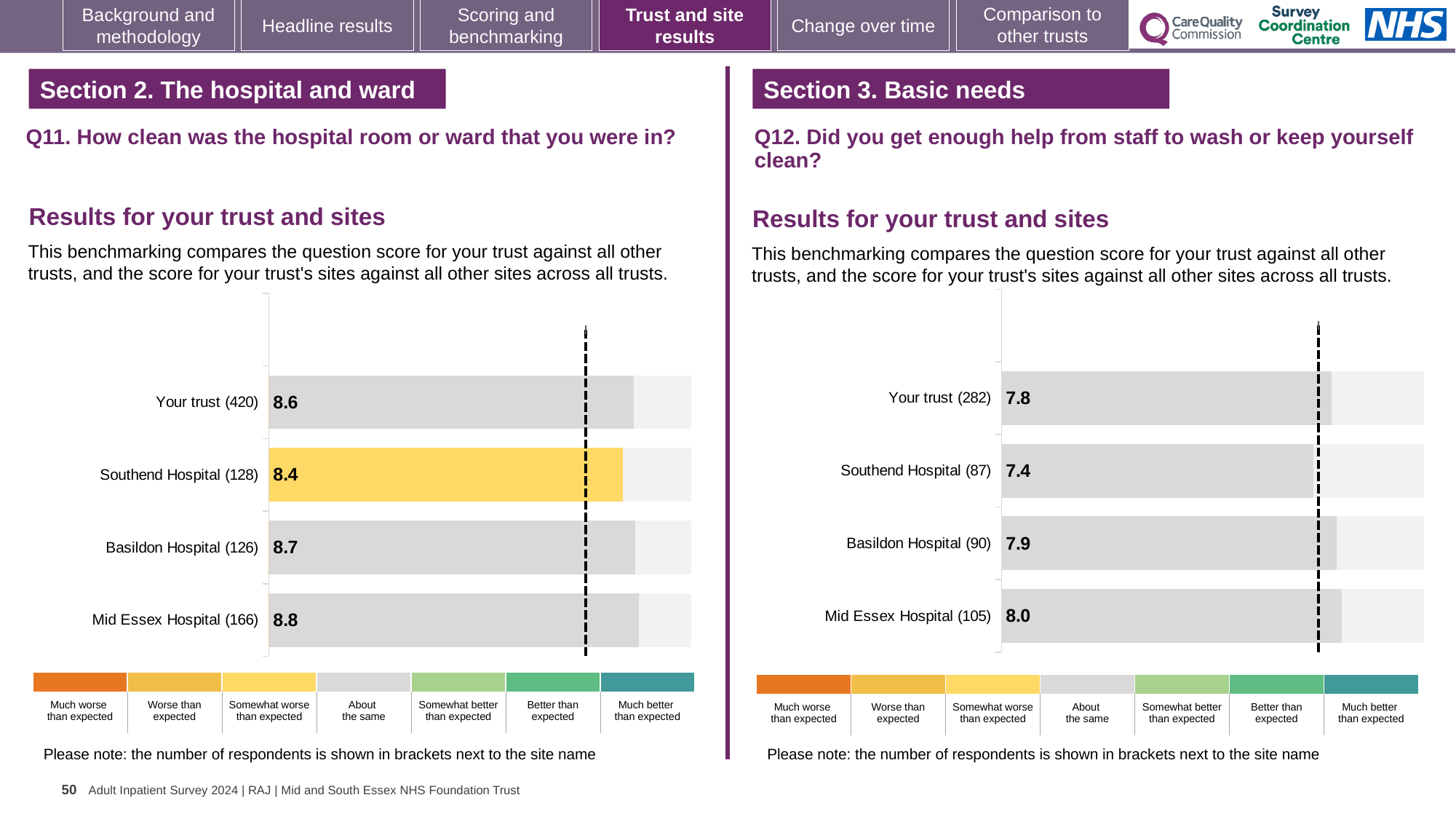
On the Q12 chart (right), what is the score for Basildon Hospital? 7.9 On the Q12 chart (right), which bar has the lowest score? Southend Hospital On the Q11 chart (left), which bar has the lowest score? Southend Hospital On the Q11 chart (left), which site has the highest score? Mid Essex Hospital On the Q11 chart (left), what is the score for Southend Hospital? 8.4 On the Q12 chart (right), what is the difference between the scores for Mid Essex Hospital and Your trust? 0.2 On the Q11 chart (left), what is the difference between the scores for Mid Essex Hospital and Southend Hospital? 0.4 On the Q11 chart (left), what is the score for Your trust? 8.6 On the Q12 chart (right), what is the score for Mid Essex Hospital? 8.0 On the Q11 chart (left), how many bars are plotted? 4 What kind of chart is used for the Q11 results on the left? Bar chart On the Q12 chart (right), which is larger, the score for Your trust or the score for Southend Hospital? Your trust